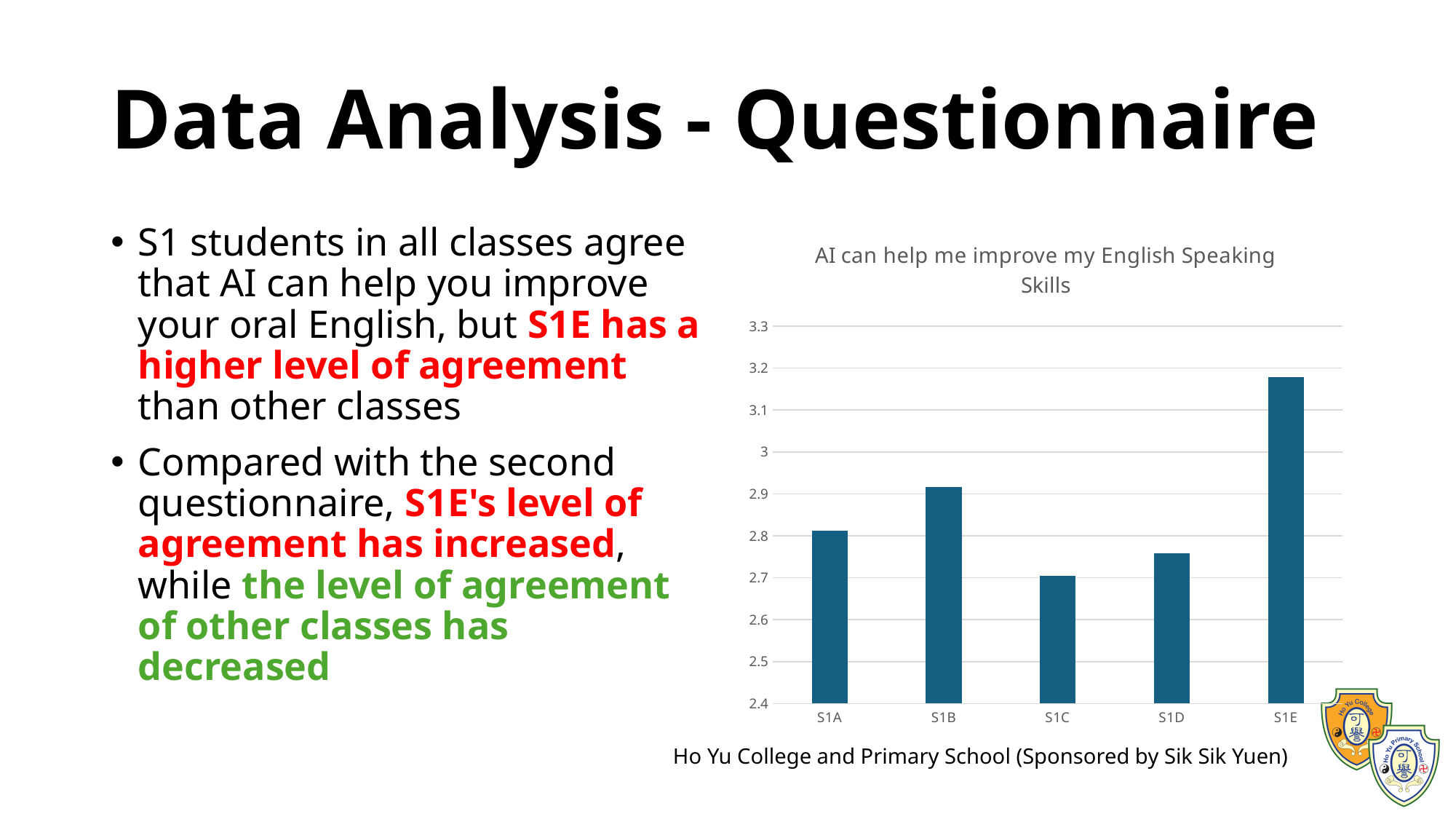
Which is larger, the value for S1C or the value for S1E? S1E What kind of chart is shown on the slide? bar chart Which class has the highest value in the chart? S1E Is the value for S1C greater or less than 2.8? less What is the title of the chart? AI can help me improve my English Speaking Skills Is the value for S1E greater or less than 3.2? less Which is larger, the value for S1A or the value for S1B? S1B Is the value for S1D greater or less than 2.7? greater How many classes are shown on the x axis of the chart? 5 Which class has the lowest value in the chart? S1C